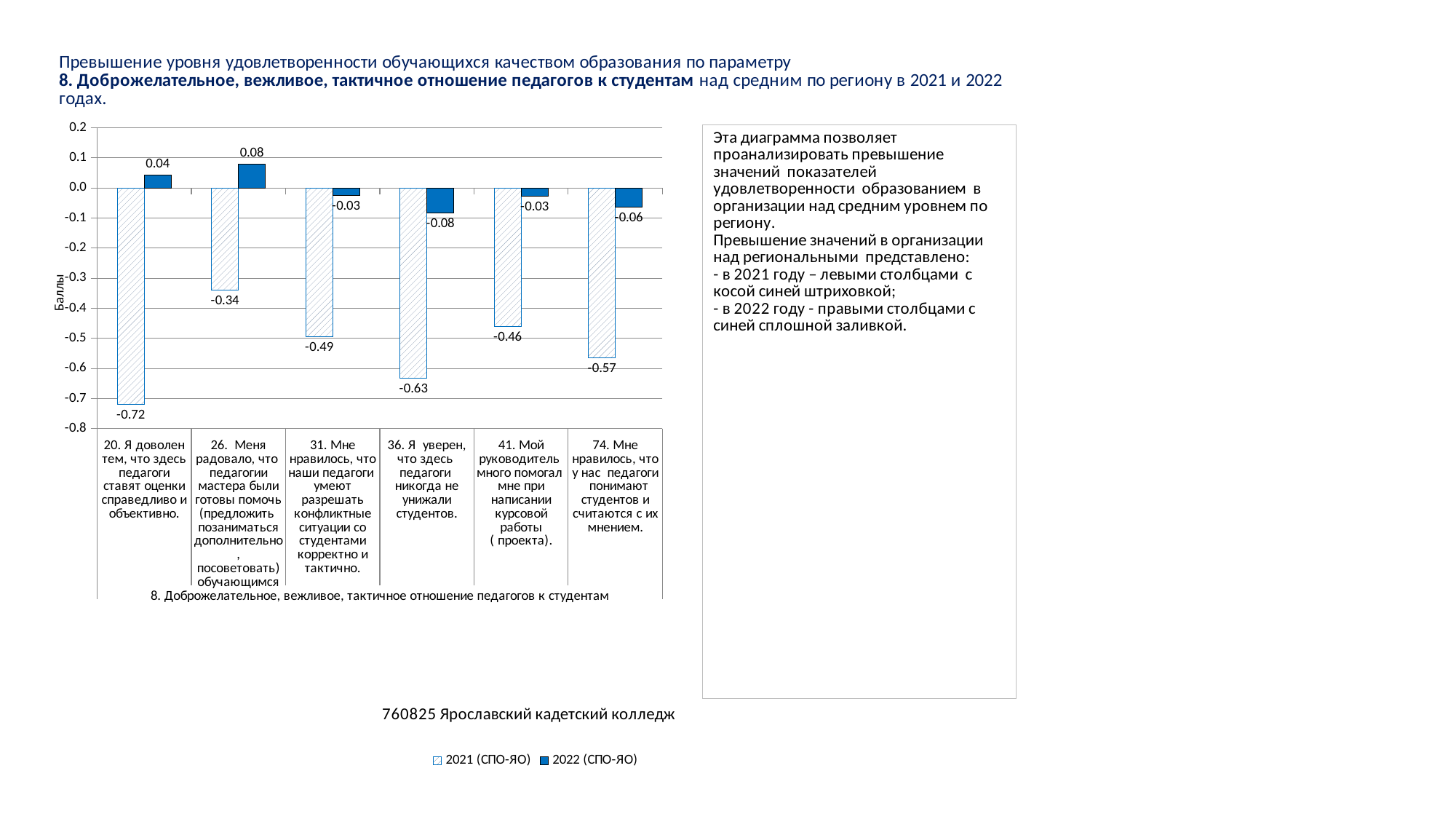
What type of chart is shown on the slide? Bar chart What is the difference between the 2022 and 2021 values for category 31 (Мне нравилось, что наши педагоги умеют разрешать конфликтные ситуации)? 0.46 How many categories are shown on the x axis of the chart? 6 What is the 2022 (СПО-ЯО) value for category 74 (Мне нравилось, что у нас педагоги понимают студентов и считаются с их мнением)? -0.06 Which is larger: the 2021 value for category 26 or the 2021 value for category 41? 2021 value for category 26 (-0.34) What is the 2021 (СПО-ЯО) value for category 20 (Я доволен тем, что здесь педагоги ставят оценки справедливо и объективно)? -0.72 Which category has the lowest 2021 (СПО-ЯО) value? 20. Я доволен тем, что здесь педагоги ставят оценки справедливо и объективно. How many series does the chart legend list? 2 What is the 2022 (СПО-ЯО) value for category 26 (Меня радовало, что педагоги и мастера были готовы помочь)? 0.08 What is the 2021 (СПО-ЯО) value for category 36 (Я уверен, что здесь педагоги никогда не унижали студентов)? -0.63 Which category has the highest 2022 (СПО-ЯО) value? 26. Меня радовало, что педагоги и мастера были готовы помочь What is the label of the vertical axis of the chart? Баллы